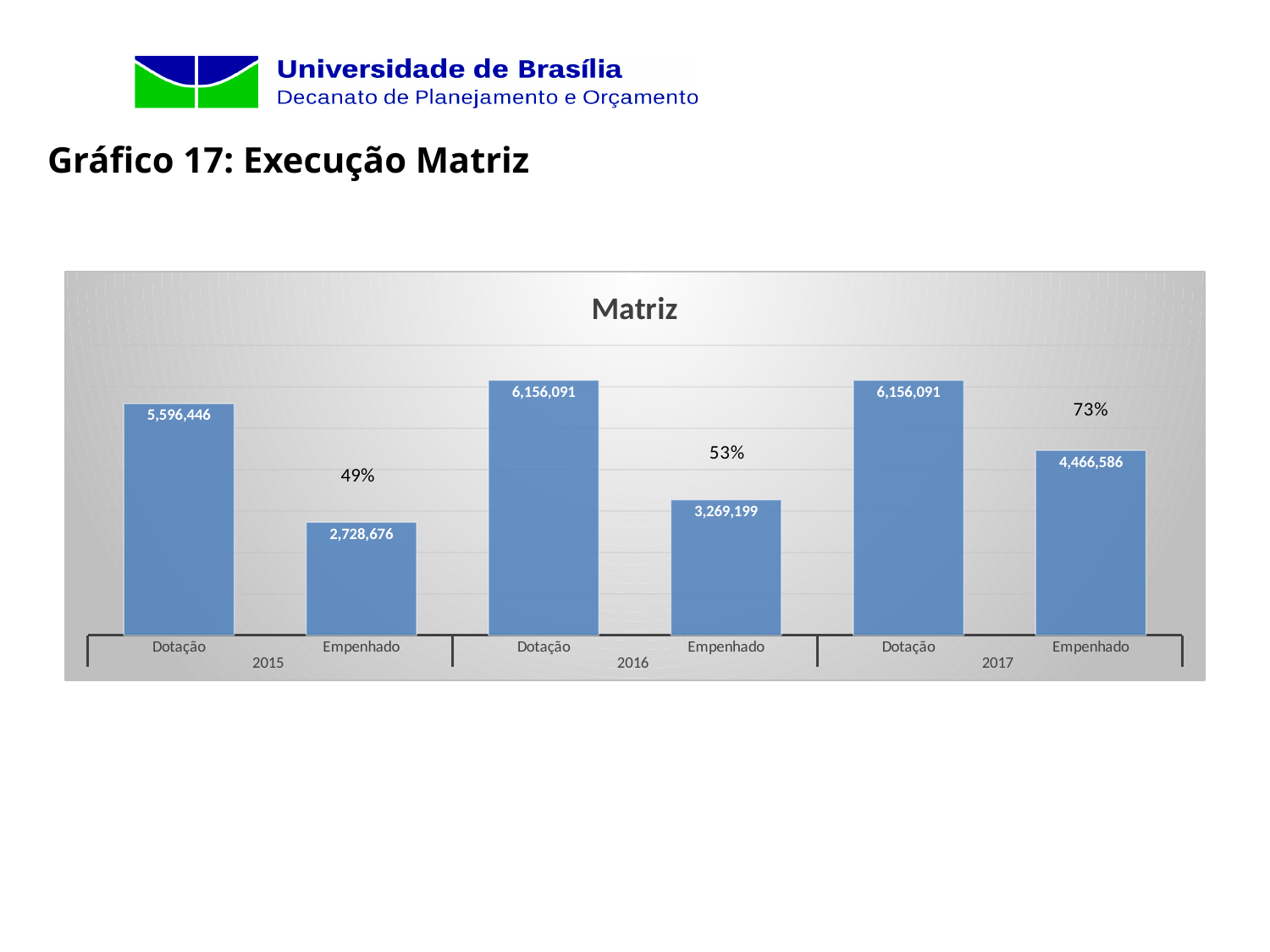
Which bar has the lowest value in the chart? Empenhado 2015 What percentage is shown above the Empenhado bar for 2017? 73% What is the value of Dotação for 2015? 5,596,446 What is the difference between Empenhado in 2017 and Empenhado in 2015? 1,737,910 What is the value of Empenhado for 2016? 3,269,199 What is the difference between Dotação and Empenhado in 2017? 1,689,505 Which year has the highest Empenhado value? 2017 What type of chart is shown? Bar chart What is the value of Empenhado for 2017? 4,466,586 How many bars are plotted in the chart? 6 Which is larger, Dotação in 2015 or Dotação in 2016? Dotação in 2016 What percentage is shown above the Empenhado bar for 2015? 49%